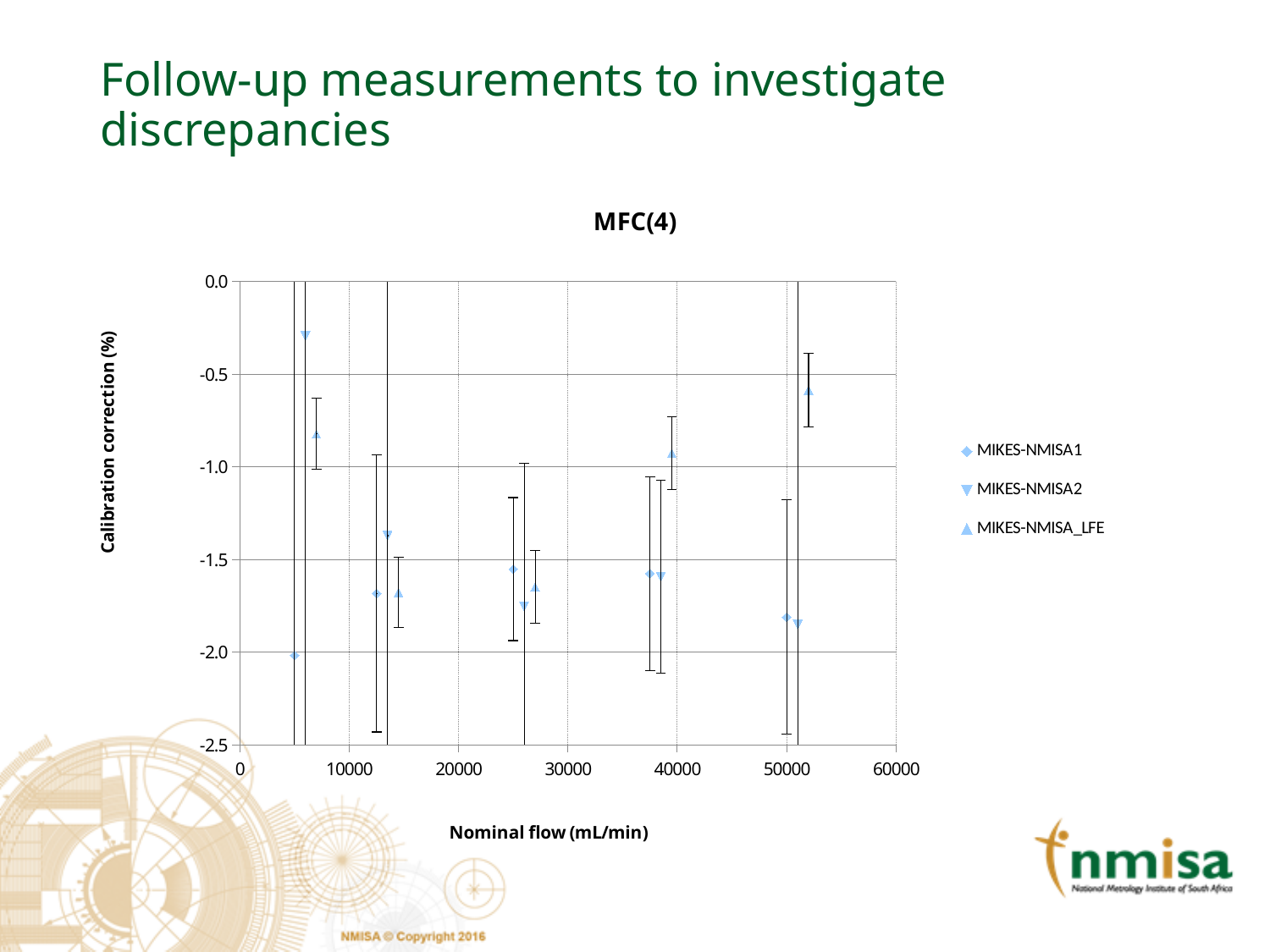
At the lowest nominal flow group (around 5000-7000 mL/min), which is higher: the MIKES-NMISA2 value or the MIKES-NMISA_LFE value? MIKES-NMISA2 How many data points are plotted for the MIKES-NMISA1 series? 5 Which series has the highest calibration correction at the highest nominal flow (around 50000-52000 mL/min)? MIKES-NMISA_LFE Which series contains the lowest plotted calibration correction on the chart? MIKES-NMISA1 What is the label of the x axis? Nominal flow (mL/min) Is the MIKES-NMISA1 value at around 50000 mL/min greater or less than -1.5? less Is the MIKES-NMISA2 value at the lowest nominal flow (around 6000 mL/min) greater or less than -0.5? greater Is the MIKES-NMISA_LFE value at the highest nominal flow (around 52000 mL/min) greater or less than -1.0? greater How many series does the legend list? 3 What kind of chart is shown on the slide? scatter chart What is the title of the chart? MFC(4)